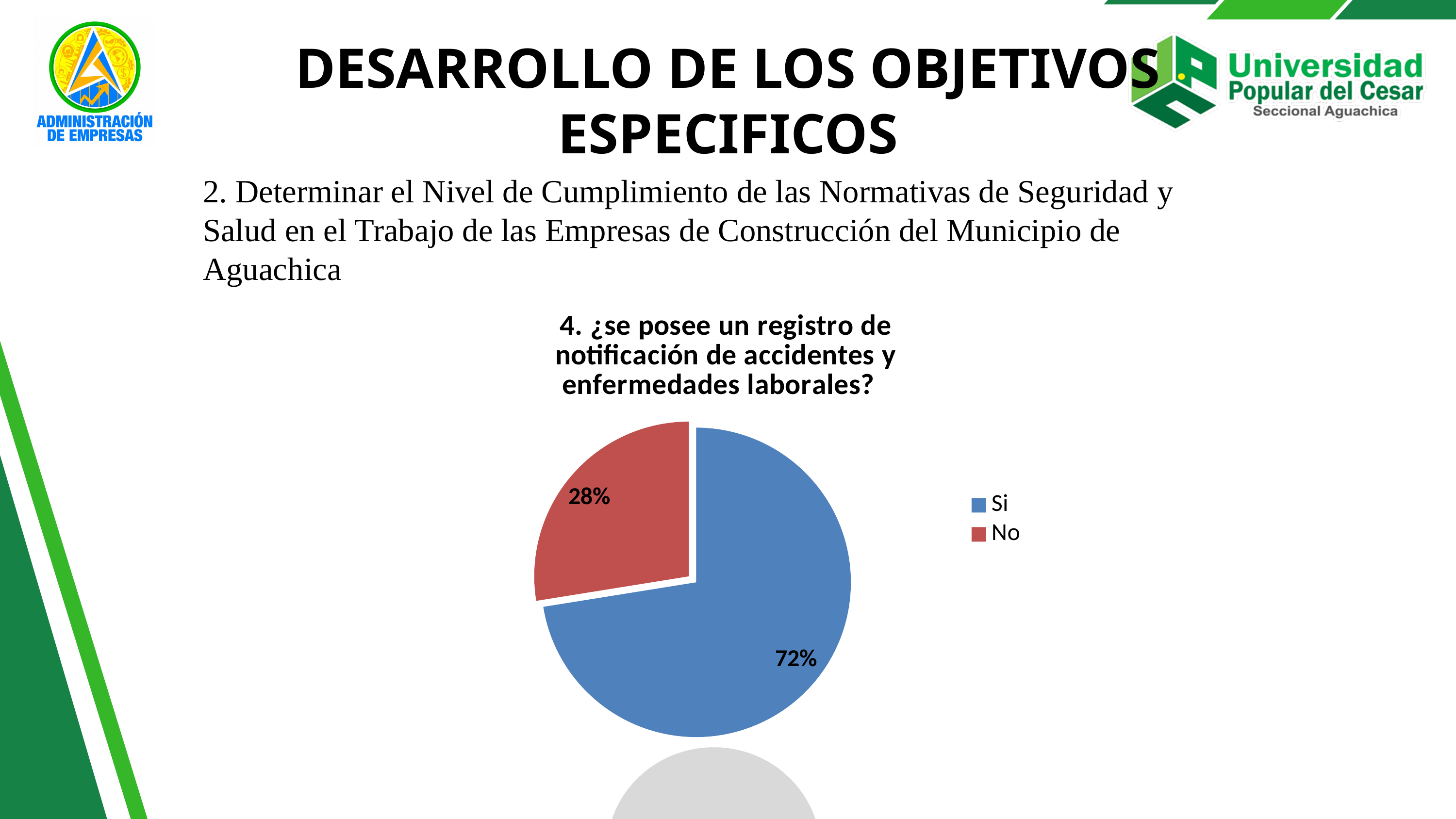
How many entries does the legend list? 2 What colour is the "No" slice in the pie chart? Red Which category has the largest share of the pie? Si What percentage of the pie corresponds to "No"? 28% How many slices does the pie chart have? 2 What is the share of the pie taken by the "Si" slice? 72% What percentage of the pie corresponds to "Si"? 72% What is the title of the pie chart? 4. ¿se posee un registro de notificación de accidentes y enfermedades laborales? What type of chart is shown on the slide? Pie chart Which category has the smallest share of the pie? No What is the difference in percentage points between the "Si" and "No" slices? 44 Which is larger, the share for "Si" or the share for "No"? Si